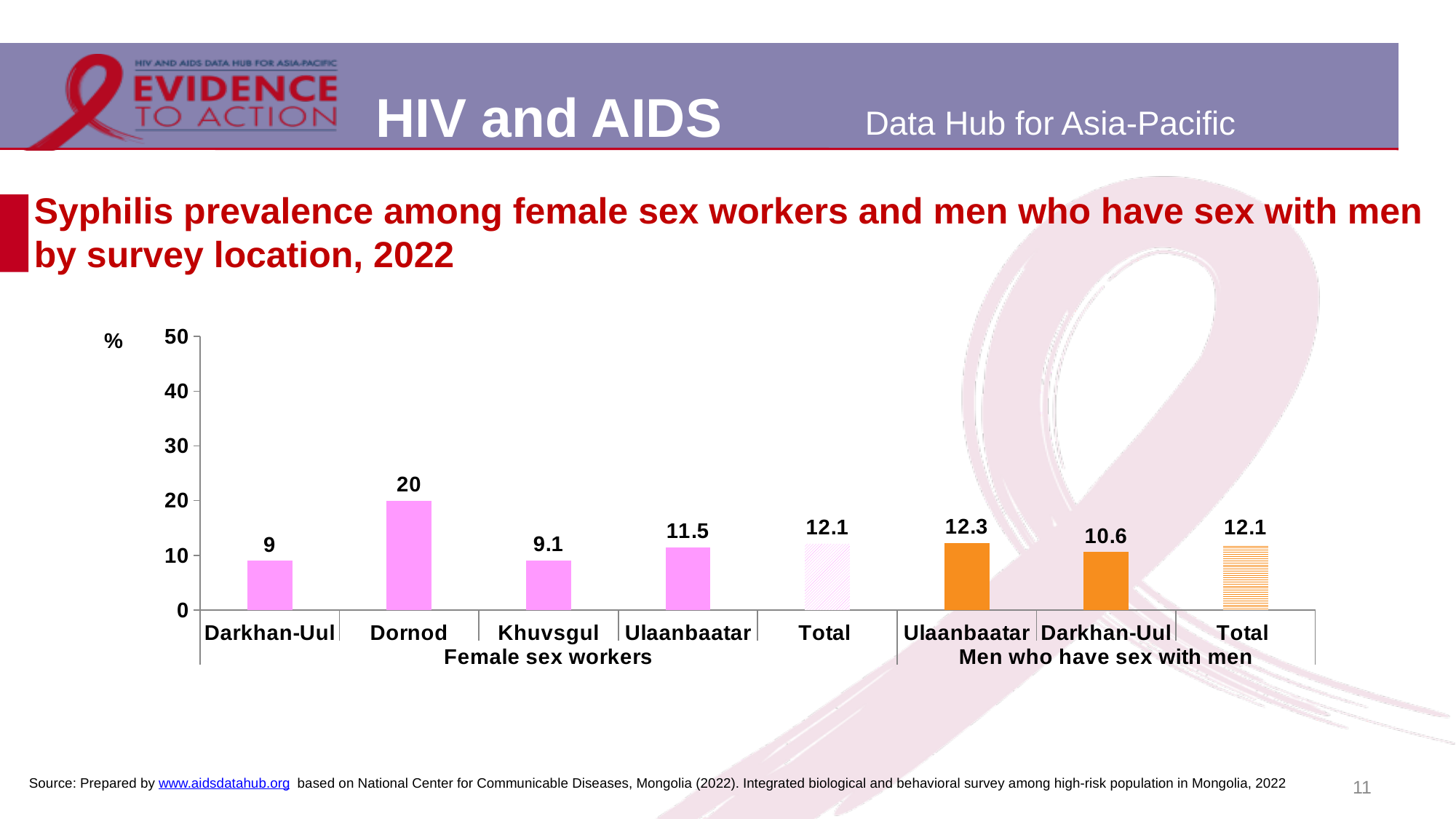
What is the syphilis prevalence among men who have sex with men in Ulaanbaatar? 12.3 Is the syphilis prevalence among female sex workers in Dornod greater or less than 30? less How many bars are plotted in the chart? 8 Which survey location has the highest syphilis prevalence among female sex workers? Dornod What type of chart is shown on the slide? Bar chart Which is larger: the syphilis prevalence among female sex workers in Ulaanbaatar or among men who have sex with men in Ulaanbaatar? Men who have sex with men in Ulaanbaatar What is the syphilis prevalence among female sex workers in Dornod? 20 What is the difference between the syphilis prevalence among female sex workers in Dornod and in Khuvsgul? 10.9 What unit is shown on the y axis of the chart? % What is the syphilis prevalence among men who have sex with men in Darkhan-Uul? 10.6 Which survey location has the lowest syphilis prevalence among female sex workers? Darkhan-Uul What is the total syphilis prevalence among female sex workers? 12.1